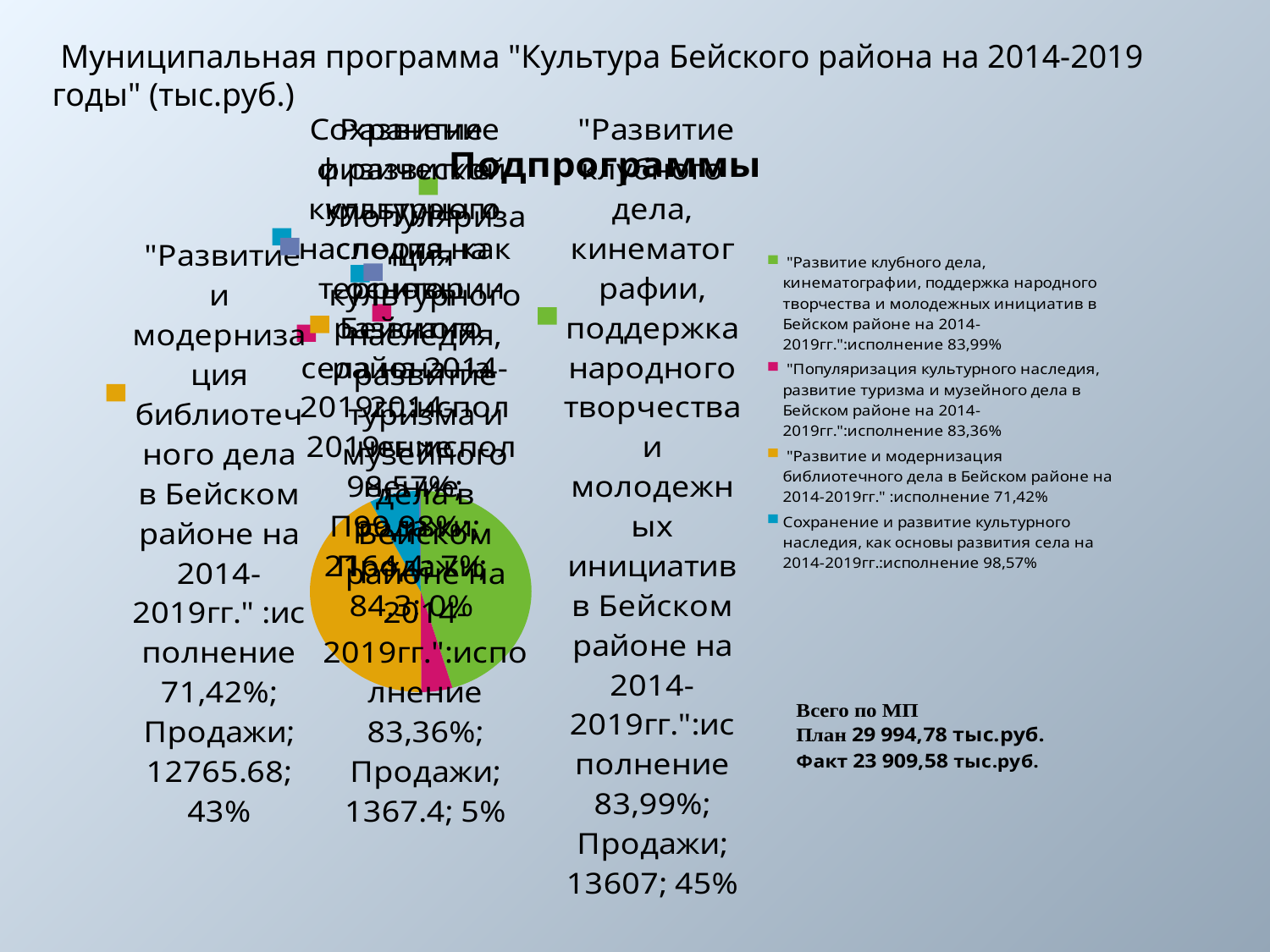
What is the title of the chart? Подпрограммы What share of the pie does the subprogram "Популяризация культурного наследия, развитие туризма и музейного дела" have? 5% Which subprogram has the largest slice of the pie? "Развитие клубного дела, кинематографии, поддержка народного творчества и молодежных инициатив" What kind of chart is shown on the slide? pie chart What value is shown for the subprogram "Популяризация культурного наследия, развитие туризма и музейного дела"? 1367.4 What colour is the slice for "Развитие клубного дела, кинематографии, поддержка народного творчества и молодежных инициатив"? green What share of the pie does the subprogram "Развитие клубного дела, кинематографии, поддержка народного творчества и молодежных инициатив" have? 45% What share of the pie does the subprogram "Развитие и модернизация библиотечного дела" have? 43% Which is larger: the value for "Развитие клубного дела..." or the value for "Развитие и модернизация библиотечного дела"? "Развитие клубного дела..." How many entries does the chart legend list? 4 What is the difference between the value for "Развитие клубного дела..." (13607) and the value for "Развитие и модернизация библиотечного дела" (12765.68)? 841.32 What value is shown for the subprogram "Развитие и модернизация библиотечного дела"? 12765.68